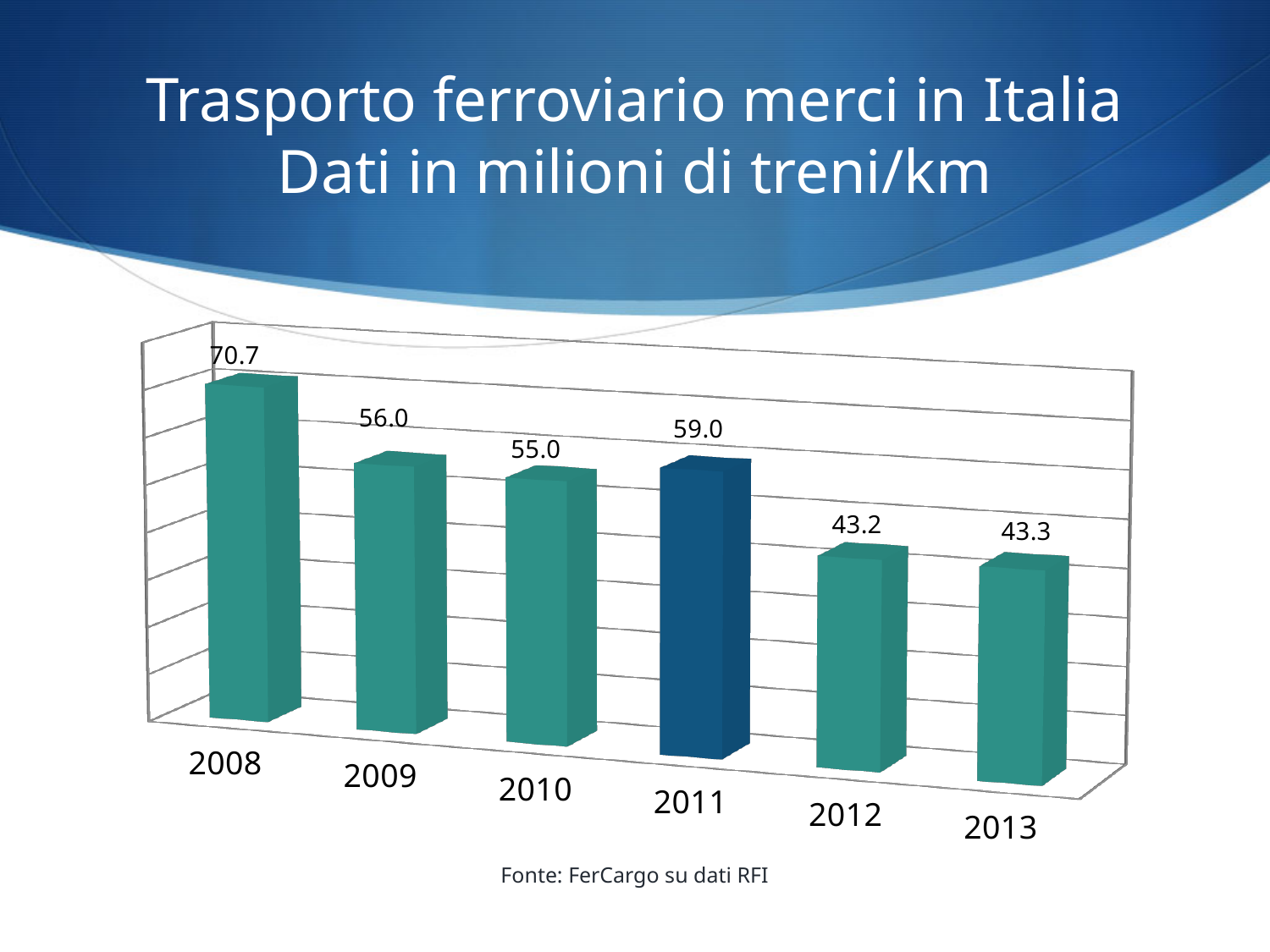
What is the value for 2011? 59.0 Which year has the lowest value? 2012 Which year has the highest value? 2008 What is the difference between the values for 2011 and 2012? 15.8 What is the value for 2013? 43.3 What kind of chart is shown on the slide? bar chart How many years are shown on the chart? 6 What is the value for 2008? 70.7 Which is larger, the value for 2010 or the value for 2011? 2011 Which bar is shown in a different (dark blue) colour from the others? 2011 What is the difference between the values for 2008 and 2009? 14.7 Do the values generally rise or fall from 2008 to 2013? fall